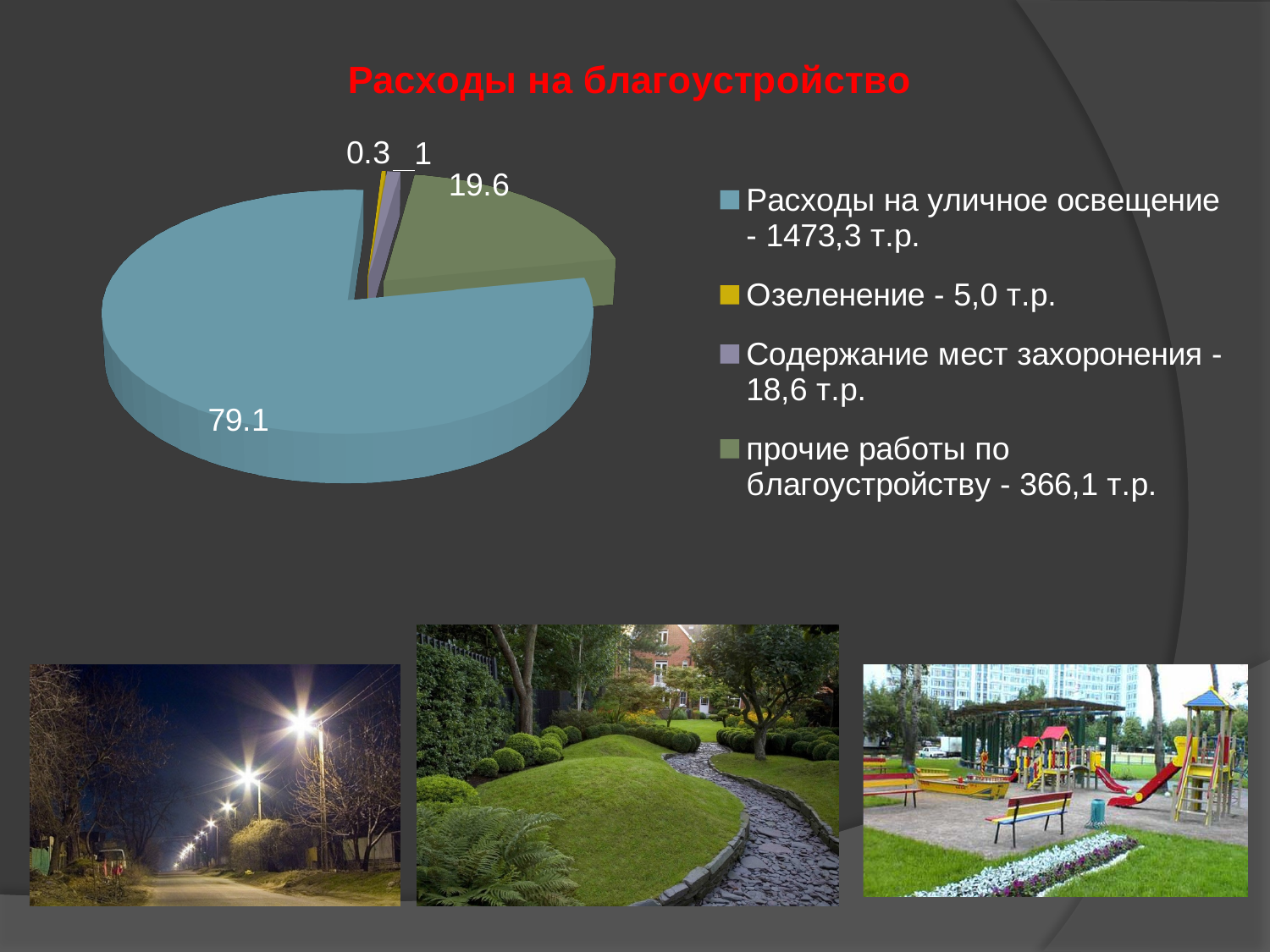
What amount in т.р. does the legend give for прочие работы по благоустройству? 366,1 т.р. What value is labelled on the slice for Содержание мест захоронения? 1 What value is labelled on the slice for Озеленение? 0.3 What kind of chart is shown on the slide? pie chart How many categories does the legend of the pie chart list? 4 Which category has the smallest slice of the pie? Озеленение What is the title of the chart? Расходы на благоустройство Which slice is larger: Содержание мест захоронения or Озеленение? Содержание мест захоронения What value is labelled on the slice for Расходы на уличное освещение? 79.1 Which category has the largest slice of the pie? Расходы на уличное освещение What is the difference between the labelled values for Расходы на уличное освещение and прочие работы по благоустройству? 59.5 What value is labelled on the slice for прочие работы по благоустройству? 19.6